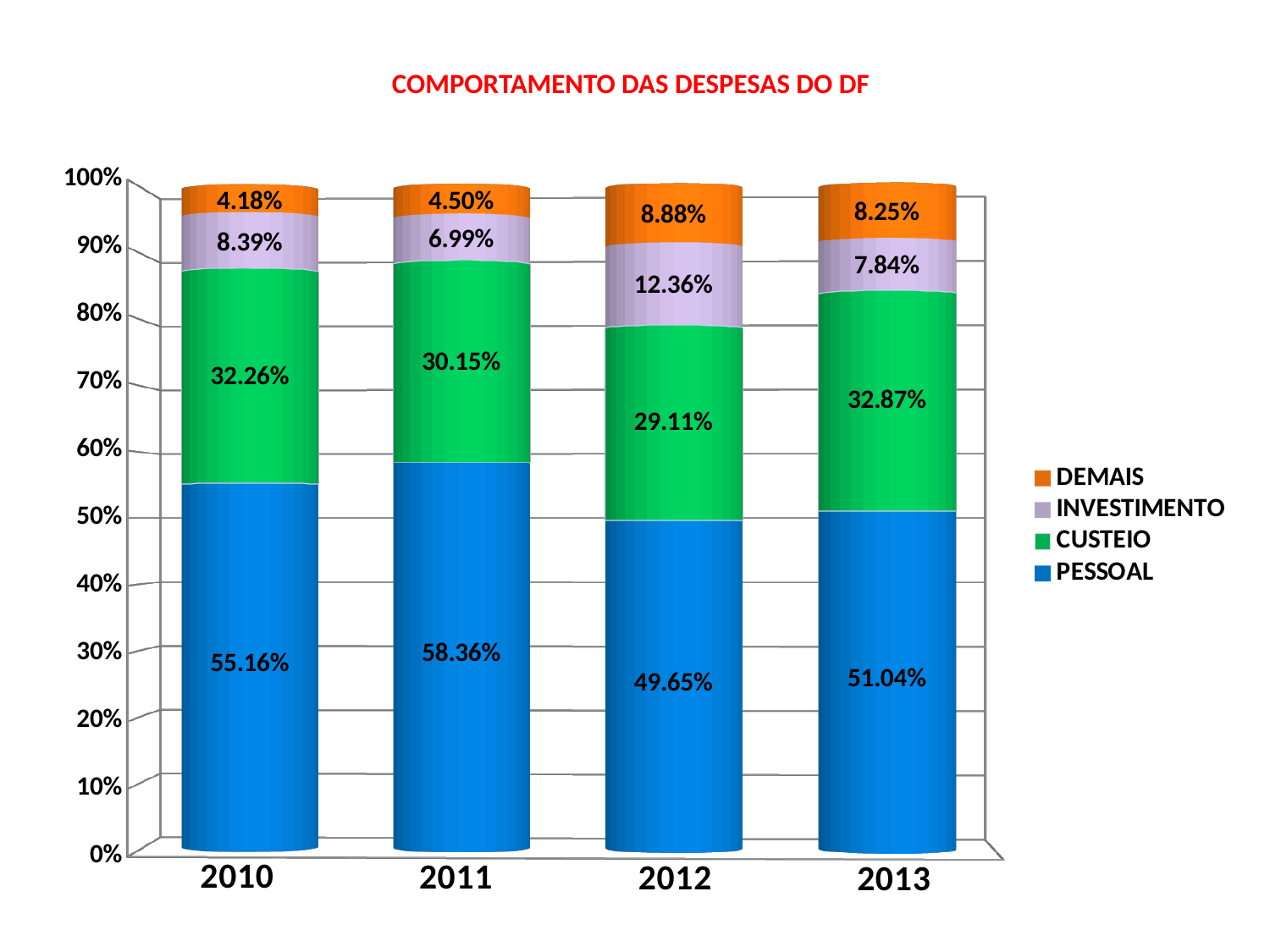
What is the title of the chart? COMPORTAMENTO DAS DESPESAS DO DF How many years are shown on the x axis? 4 What is the PESSOAL value for 2011? 58.36% In which year is the CUSTEIO share lowest? 2012 How many series does the legend list? 4 Which is larger, the INVESTIMENTO value for 2010 or for 2013? 2010 In which year is the PESSOAL share highest? 2011 What is the DEMAIS value for 2010? 4.18% What is the INVESTIMENTO value for 2012? 12.36% What is the difference between the PESSOAL values for 2011 and 2012? 8.71% What is the CUSTEIO value for 2013? 32.87% What kind of chart is shown? Stacked bar chart